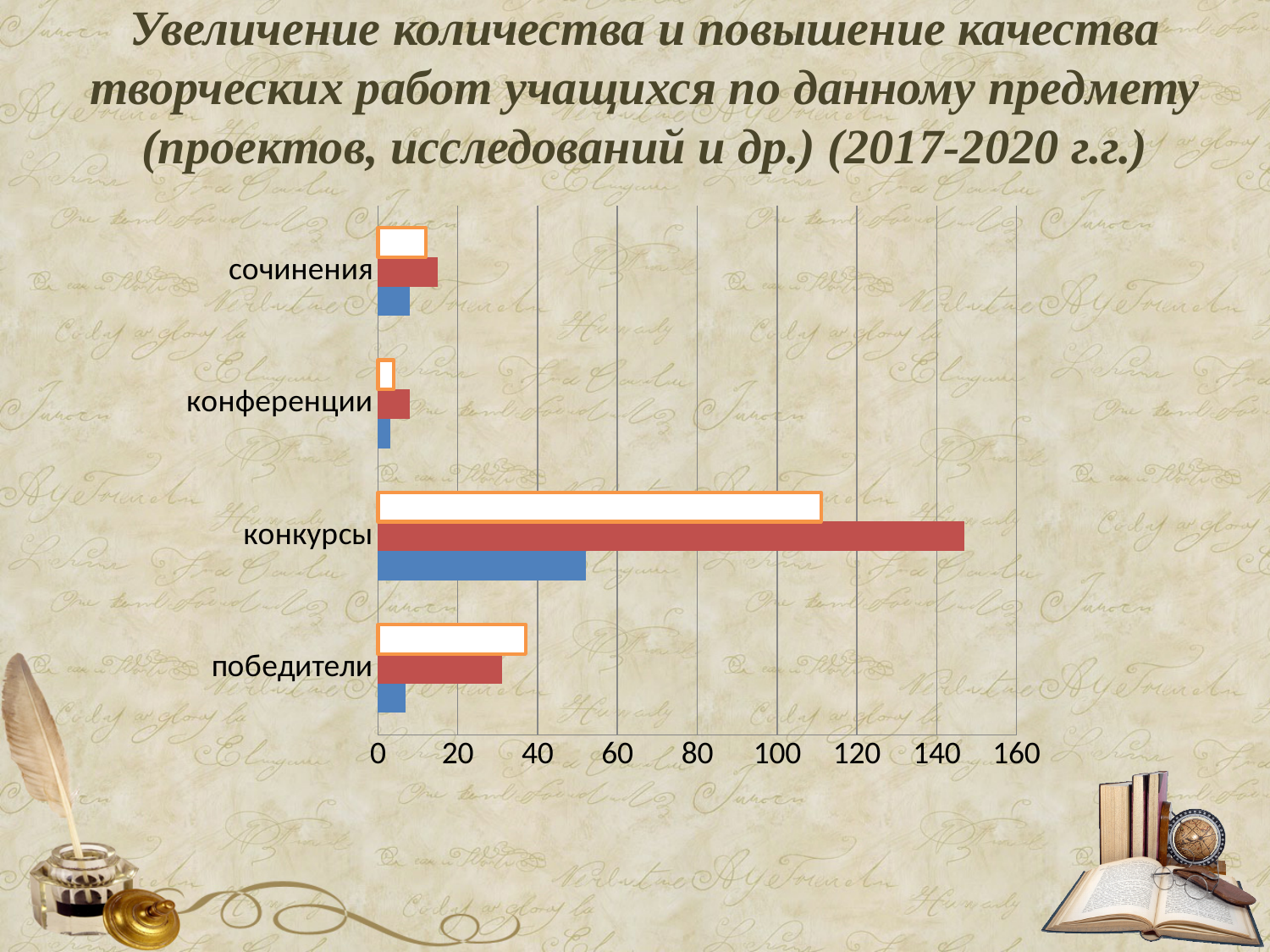
Is the value of the red bar for конкурсы greater or less than 140? greater Which category has the shortest bars on the chart? конференции Is the value of the red bar for сочинения greater or less than 20? less Is the value of the white bar for конкурсы greater or less than 100? greater Which category has the longest bars on the chart? конкурсы What is the highest value shown on the horizontal axis of the chart? 160 What kind of chart is shown on the slide? bar chart For конкурсы, which bar is longer: the red bar or the blue bar? the red bar How many categories are shown on the chart? 4 Which category has a longer red bar: победители or сочинения? победители